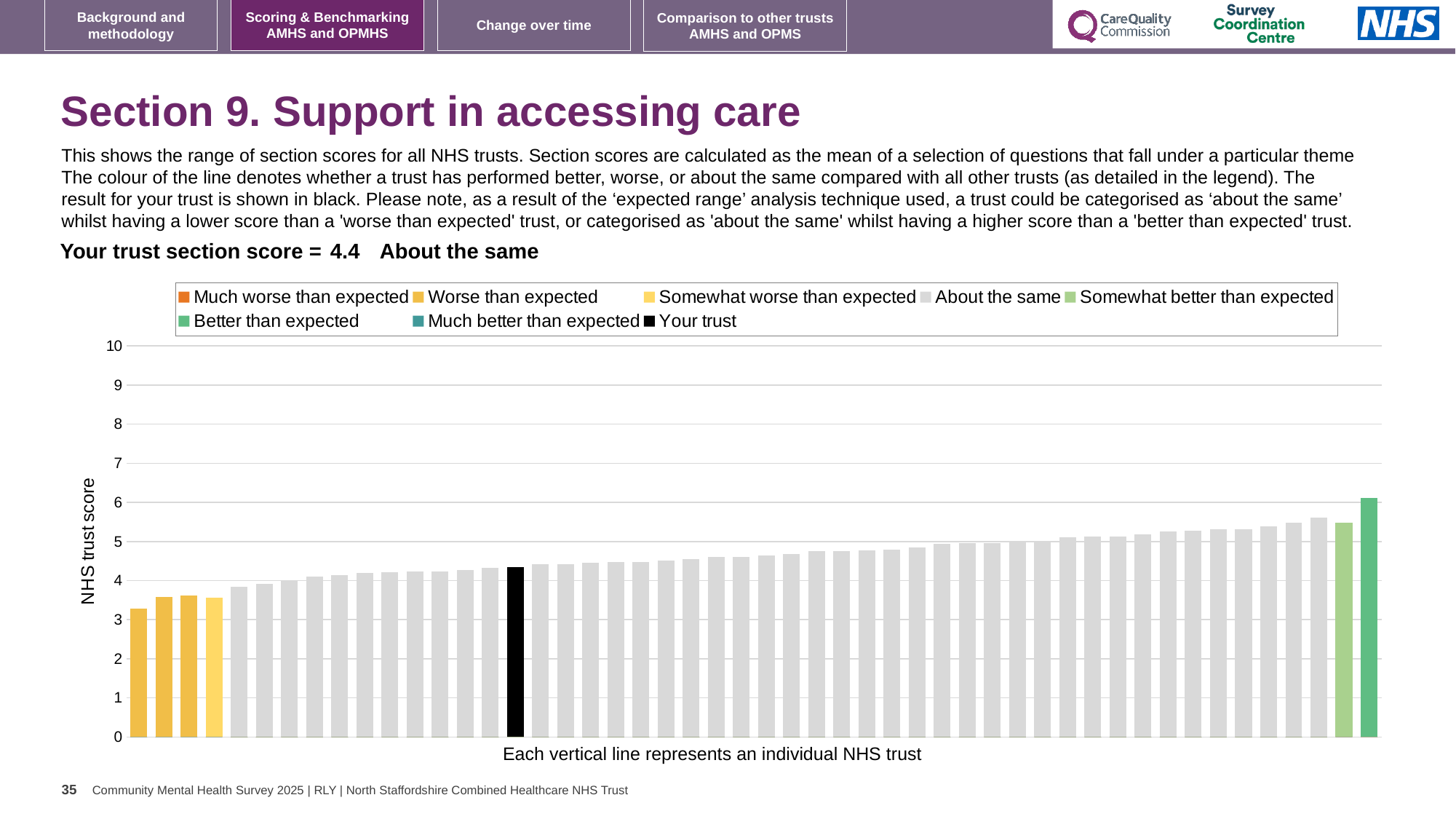
Do the bar values rise or fall from left to right along the x axis? rise Which category is your trust placed in for this section? About the same Is the value for your trust (the black bar) greater or less than 5? less What is the label on the vertical axis of the chart? NHS trust score How many entries does the chart legend list? 8 What is the section score for your trust shown on the slide? 4.4 Is the value for your trust (the black bar) greater or less than 4? greater Is the value of the lowest bar in the chart greater or less than 3? greater What kind of chart is shown on the slide? bar chart Is your trust's score higher or lower than the highest-scoring trust in the chart? lower What does the caption below the chart say each vertical line represents? an individual NHS trust